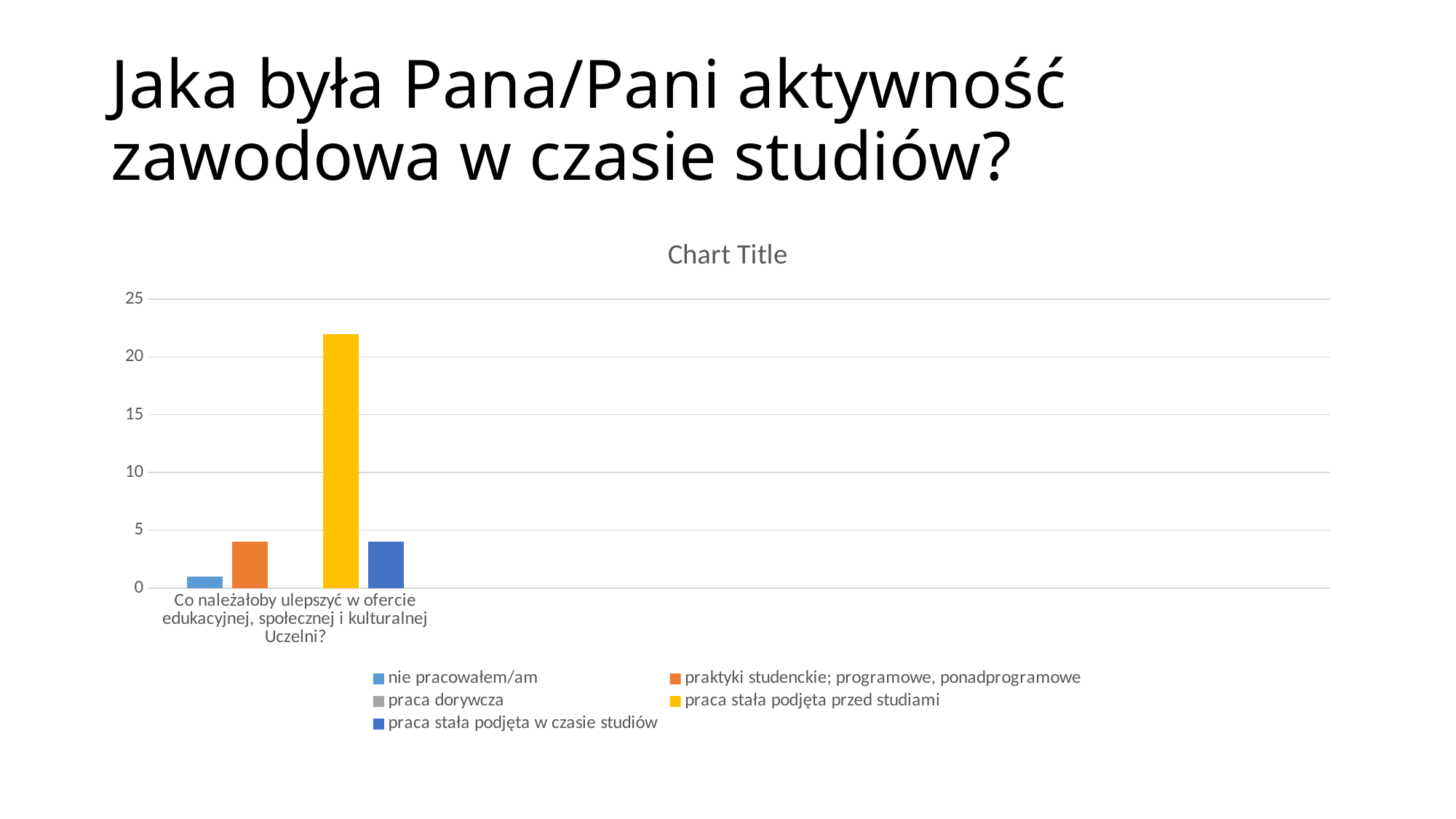
How many categories are shown on the x axis of the chart? 1 Is the value for 'praca stała podjęta przed studiami' greater or less than 20? greater What kind of chart is shown on the slide? bar chart Is the value for 'nie pracowałem/am' greater or less than 5? less Which series has the highest bar in the chart? praca stała podjęta przed studiami How many series does the chart legend list? 5 What is the title shown above the chart? Chart Title Is the value for 'praca stała podjęta przed studiami' greater or less than 25? less What colour is the bar for 'praca stała podjęta przed studiami'? yellow Which is larger: the value for 'praca stała podjęta przed studiami' or the value for 'praktyki studenckie; programowe, ponadprogramowe'? praca stała podjęta przed studiami Which is larger: the value for 'nie pracowałem/am' or the value for 'praca stała podjęta w czasie studiów'? praca stała podjęta w czasie studiów